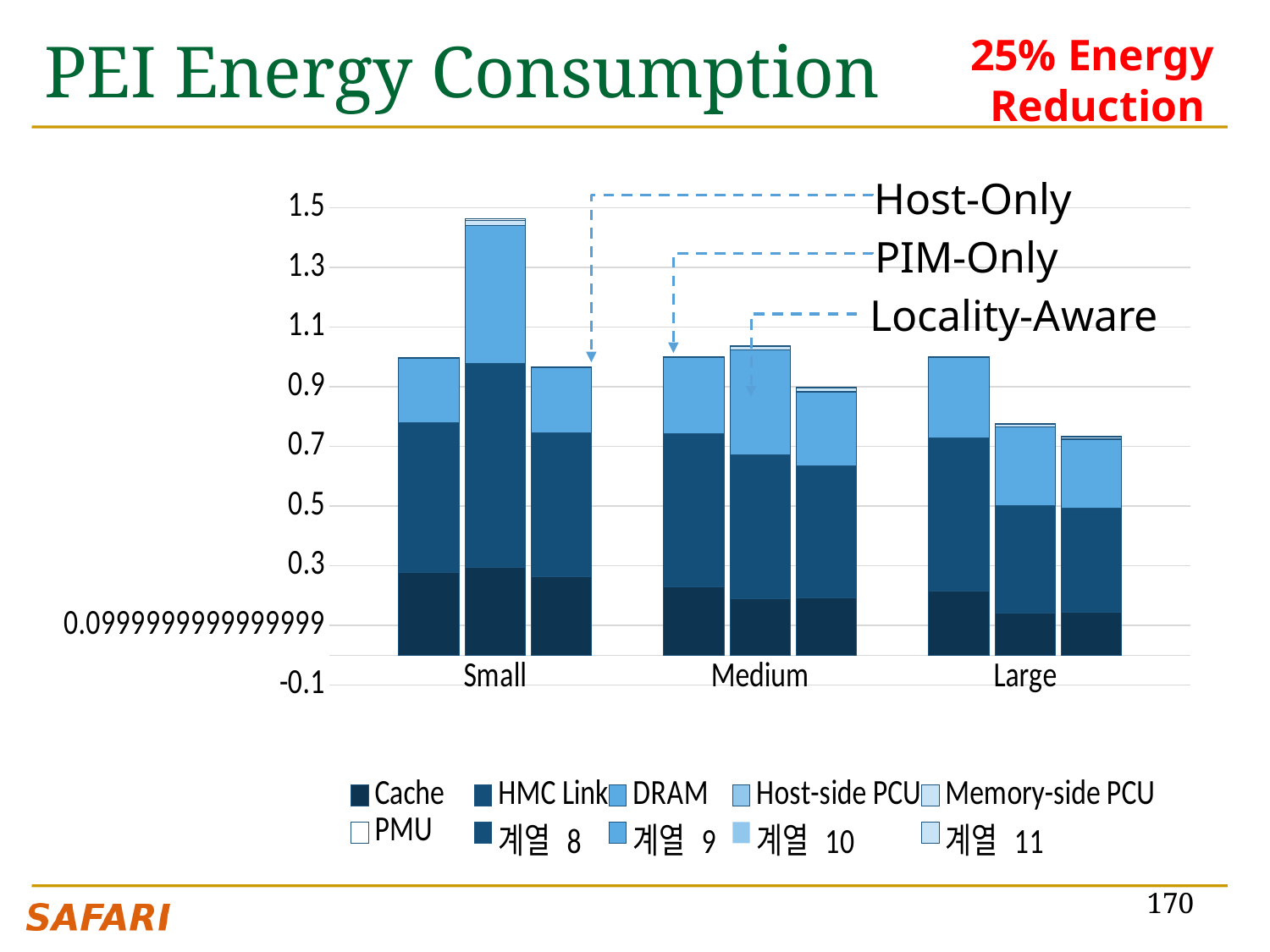
What is the title of the chart on the slide? PEI Energy Consumption What energy reduction is highlighted in red at the top right of the slide? 25% Energy Reduction Is the total value of the Locality-Aware bar for Large greater or less than 0.9? less Do the Locality-Aware bars rise or fall from Small to Large? fall What kind of chart is shown on the slide? stacked bar chart How many series does the legend list? 10 Which bar is the tallest in the chart? PIM-Only for Small Is the total value of the PIM-Only bar for Small greater or less than 1.3? greater How many categories are shown on the x axis? 3 For the Small category, which bar is taller: Host-Only or PIM-Only? PIM-Only Is the total value of the PIM-Only bar for Large greater or less than 0.9? less